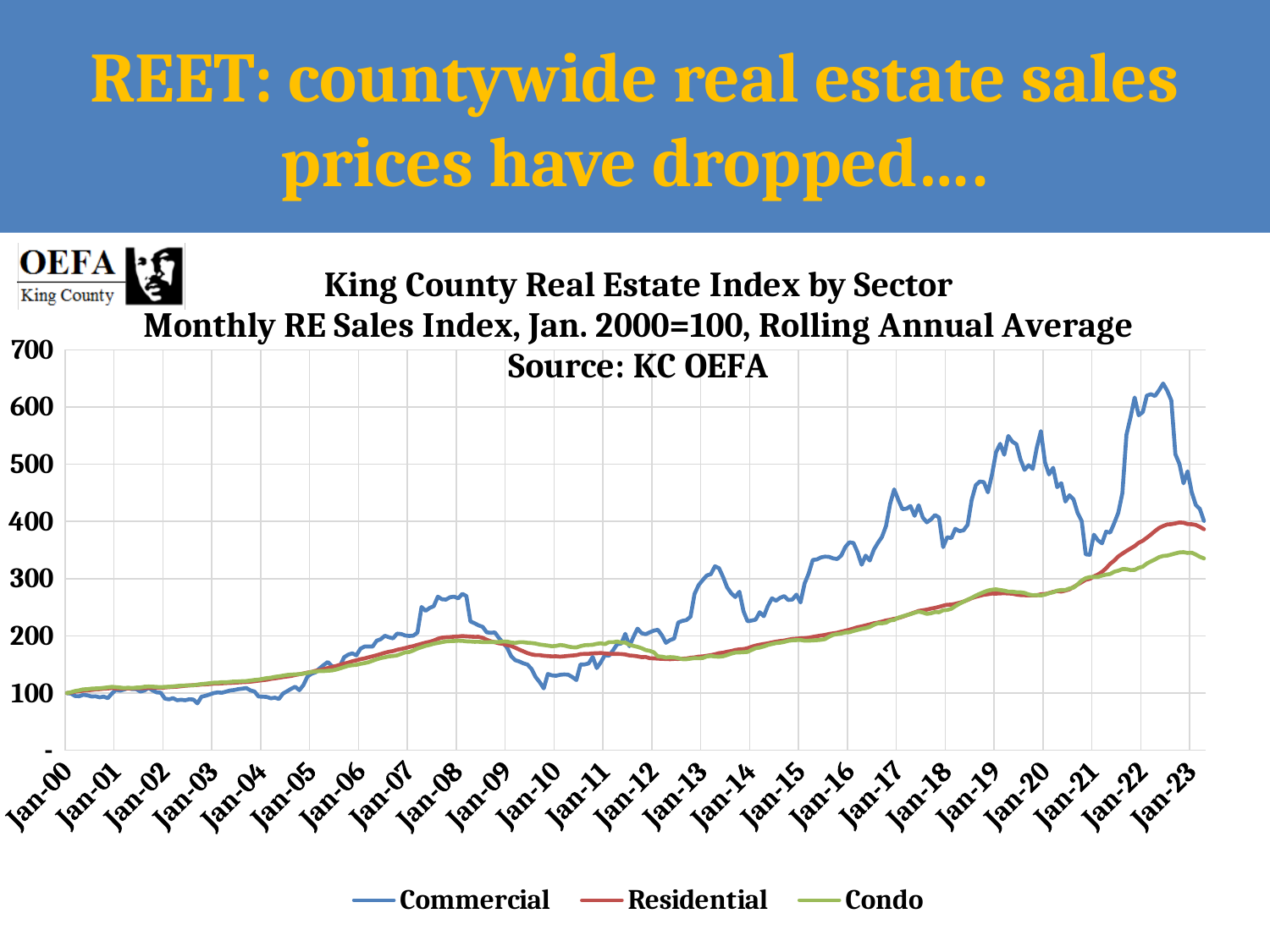
At Jan-23, which is larger, Commercial or Condo? Commercial What is the index value of all three series at Jan-00? 100 How many year labels are shown on the x axis? 24 Which series has the lowest value at Jan-23? Condo Is the value for Commercial at Jan-10 greater or less than 200? less Does the Commercial series rise or fall between Jan-22 and Jan-23? fall What is the title of the chart? King County Real Estate Index by Sector Is the value for Commercial at Jan-22 greater or less than 500? greater What are the three series named in the legend? Commercial, Residential, Condo Which series reaches the highest value on the chart? Commercial What kind of chart is shown on the slide? line chart How many series does the legend list? 3